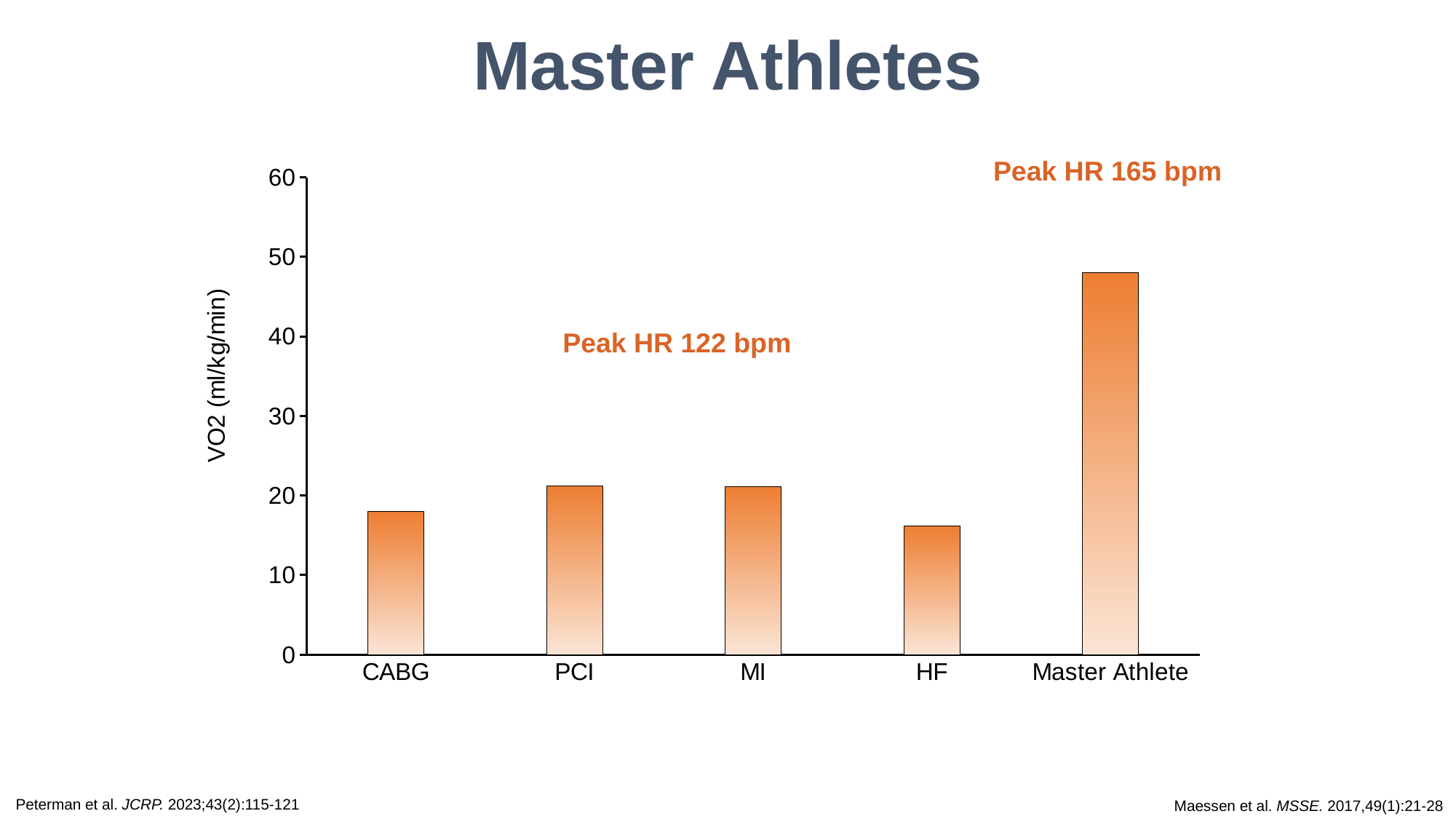
What peak heart rate is annotated above the Master Athlete bar? Peak HR 165 bpm What kind of chart is shown on the slide? bar chart Which is larger, the value for PCI or the value for HF? PCI Which is larger, the value for Master Athlete or the value for MI? Master Athlete What is the label on the y axis of the chart? VO2 (ml/kg/min) Is the value for HF greater or less than 20? less Is the value for Master Athlete greater or less than 40? greater Is the value for CABG greater or less than 20? less Which category has the highest VO2 value? Master Athlete Which category has the lowest VO2 value? HF How many categories are plotted on the x axis? 5